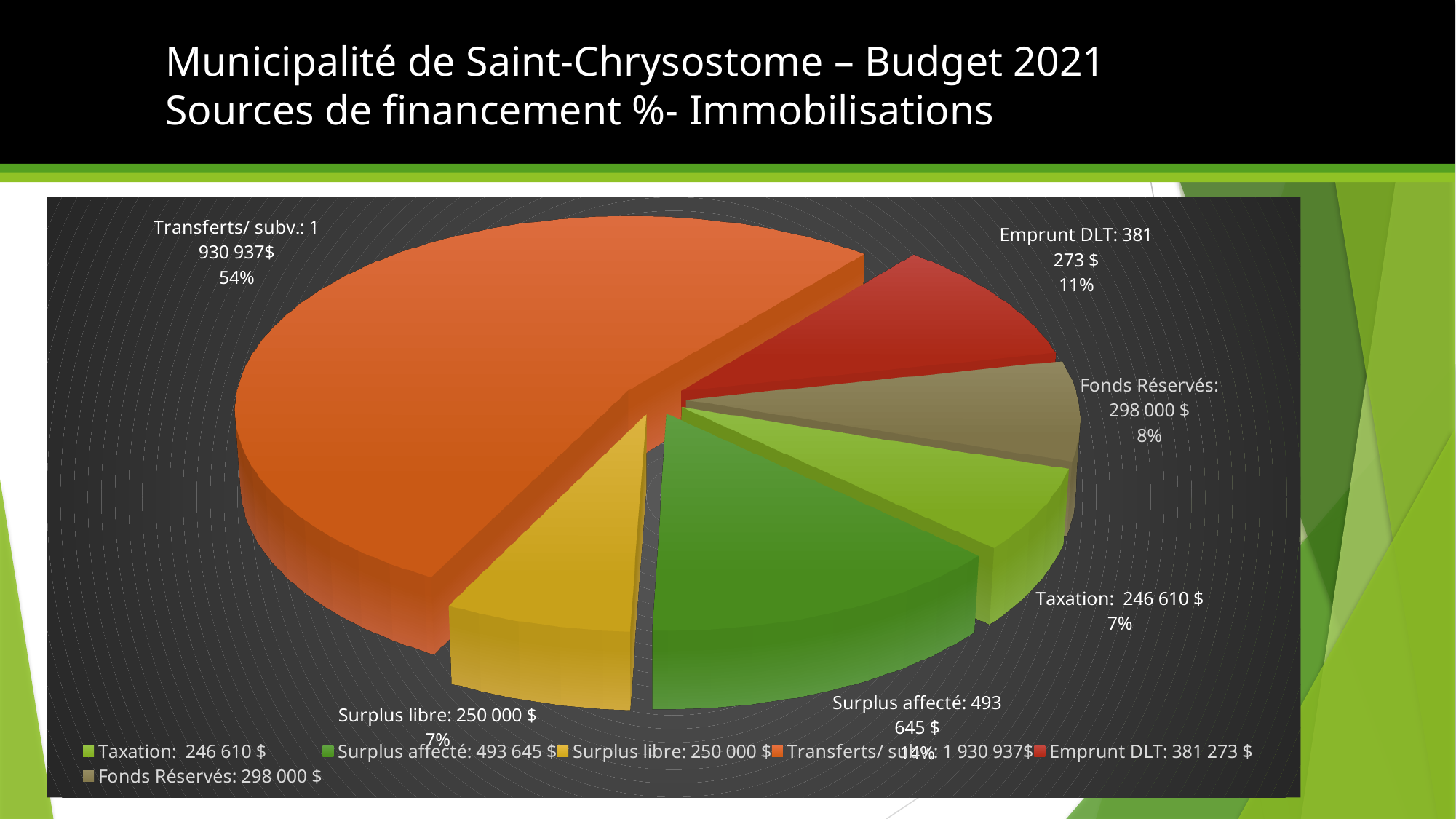
Which source of financing has the smallest dollar amount? Taxation What kind of chart is shown on the slide? Pie chart What is the difference in percentage points between the Transferts/ subv. share and the Surplus affecté share? 40 What share of the pie does Emprunt DLT represent? 11% Which source of financing has the largest share of the pie? Transferts/ subv. How many entries does the legend list? 6 What share of the pie does Transferts/ subv. represent? 54% Which has a larger share of the pie, Emprunt DLT or Fonds Réservés? Emprunt DLT How many slices does the pie chart have? 6 What is the dollar amount shown for Fonds Réservés? 298 000 $ What share of the pie does Surplus affecté represent? 14% What is the dollar amount shown for Surplus libre? 250 000 $